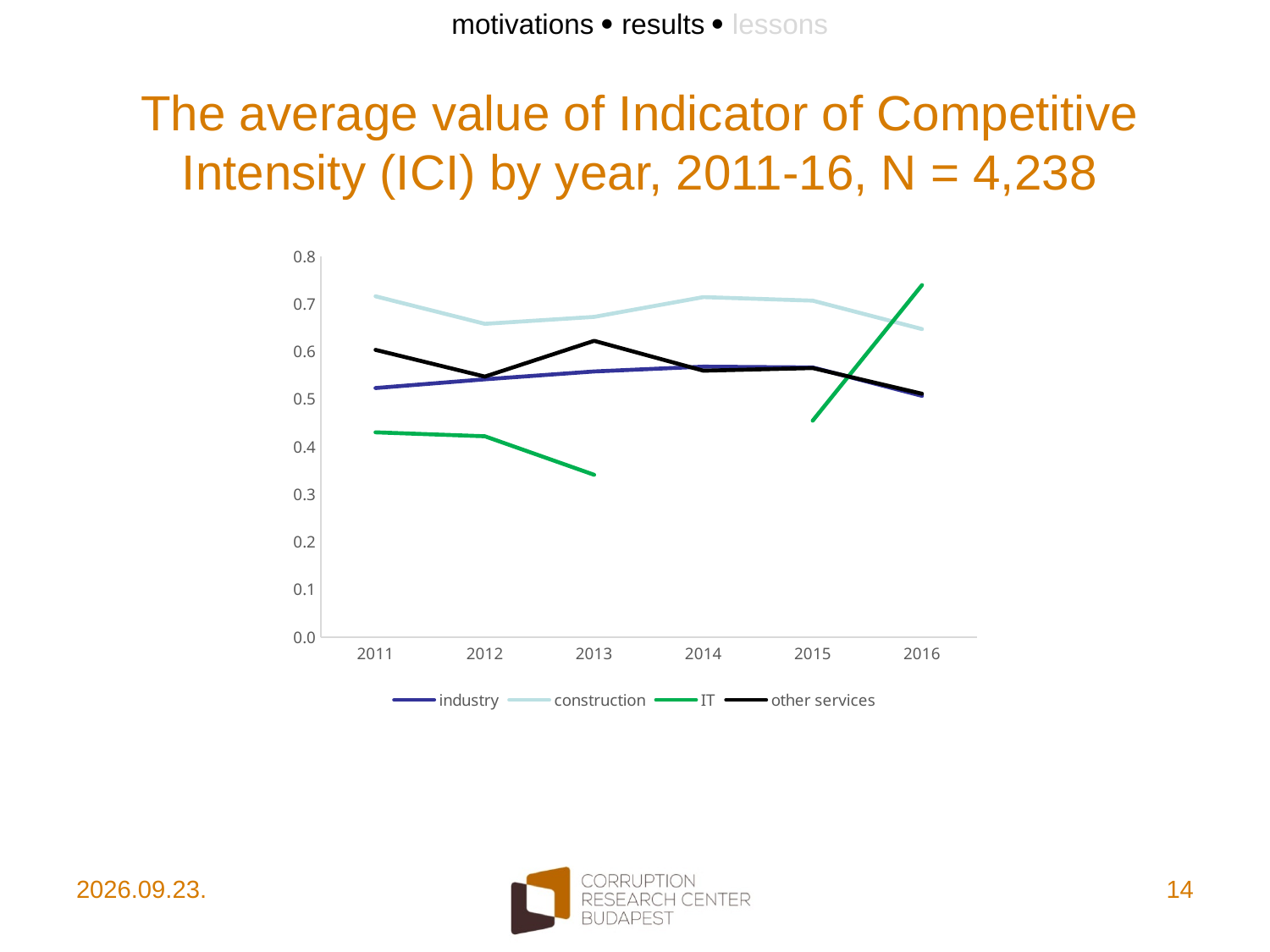
Which series has the highest value in 2011? construction Is the value for IT in 2013 greater or less than 0.4? less What kind of chart is shown on the slide? line chart How many years are shown on the x axis? 6 Is the value for IT in 2016 greater or less than 0.7? greater Which series has the lowest value in 2013? IT How many series does the legend list? 4 Does the IT line rise or fall from 2011 to 2013? fall In 2013, which is larger: other services or industry? other services Is the value for industry in 2011 greater or less than 0.6? less What is the title of the chart? The average value of Indicator of Competitive Intensity (ICI) by year, 2011-16, N = 4,238 Which series has the highest value in 2016? IT